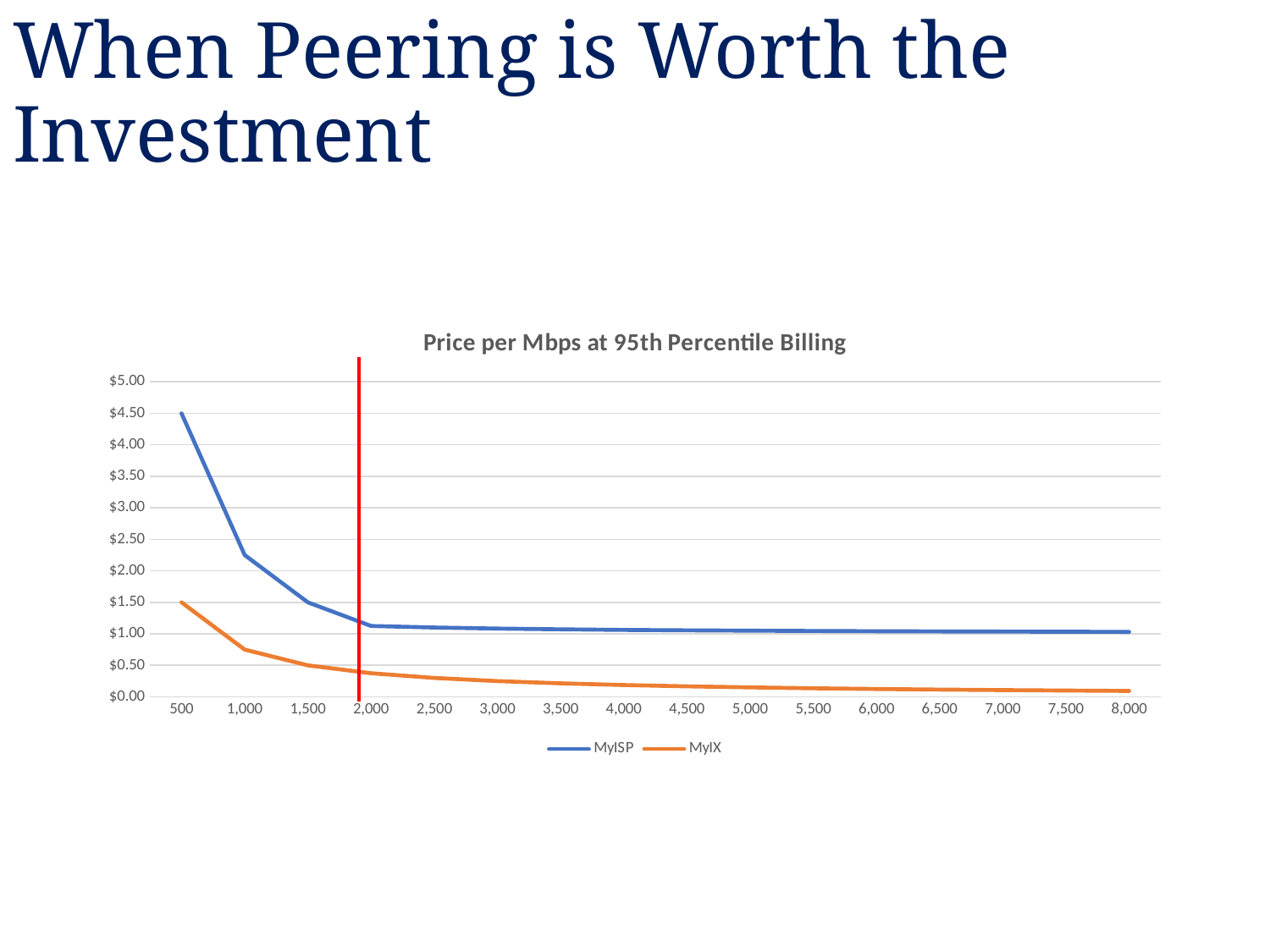
Is the value for MyIX at 8,000 greater or less than $0.50? less What kind of chart is shown on the slide? line chart Is the value for MyISP at 1,000 greater or less than $2.00? greater Is the value for MyIX at 1,000 greater or less than $1.00? less What is the value for MyISP at 500? $4.50 Which series is drawn in orange? MyIX Do the MyISP values rise or fall as the x axis increases from 500 to 8,000? fall What is the title of the chart? Price per Mbps at 95th Percentile Billing Which series has the higher value at 500, MyISP or MyIX? MyISP How many points are plotted along the x axis for each series? 16 How many series does the legend list? 2 What is the value for MyIX at 500? $1.50